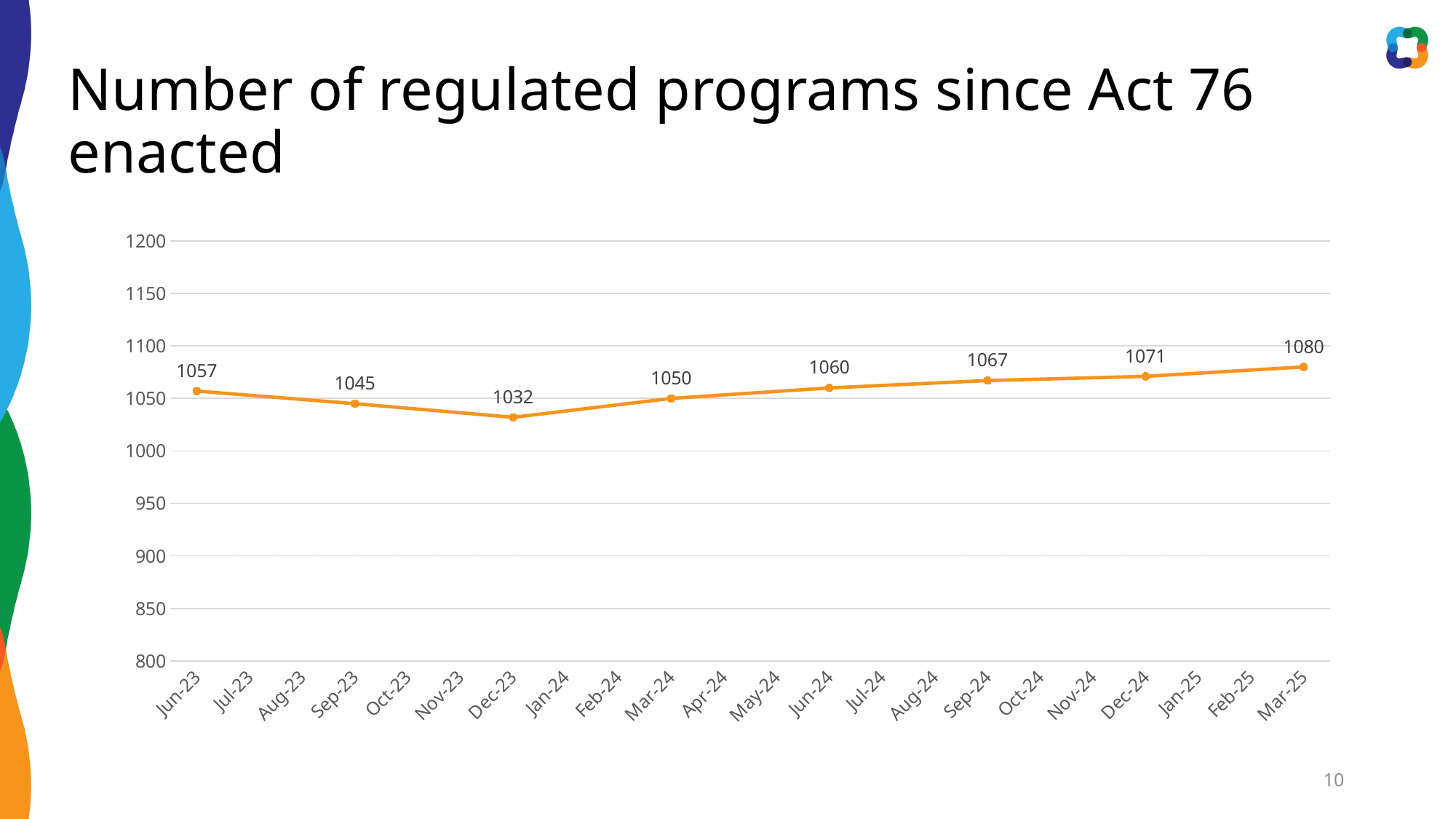
What is the number of regulated programs in Jun-23? 1057 Which month has the highest number of regulated programs? Mar-25 What is the number of regulated programs in Dec-23? 1032 Which month has the lowest number of regulated programs? Dec-23 What kind of chart is shown on the slide? line chart Is the value for Dec-24 greater or less than 1100? less What is the difference between the number of regulated programs in Mar-25 and Dec-23? 48 Which is larger, the value for Jun-23 or the value for Mar-24? Jun-23 What is the number of regulated programs in Mar-25? 1080 What is the difference between the number of regulated programs in Jun-23 and Sep-23? 12 What is the number of regulated programs in Sep-24? 1067 How many data points are plotted on the line? 8